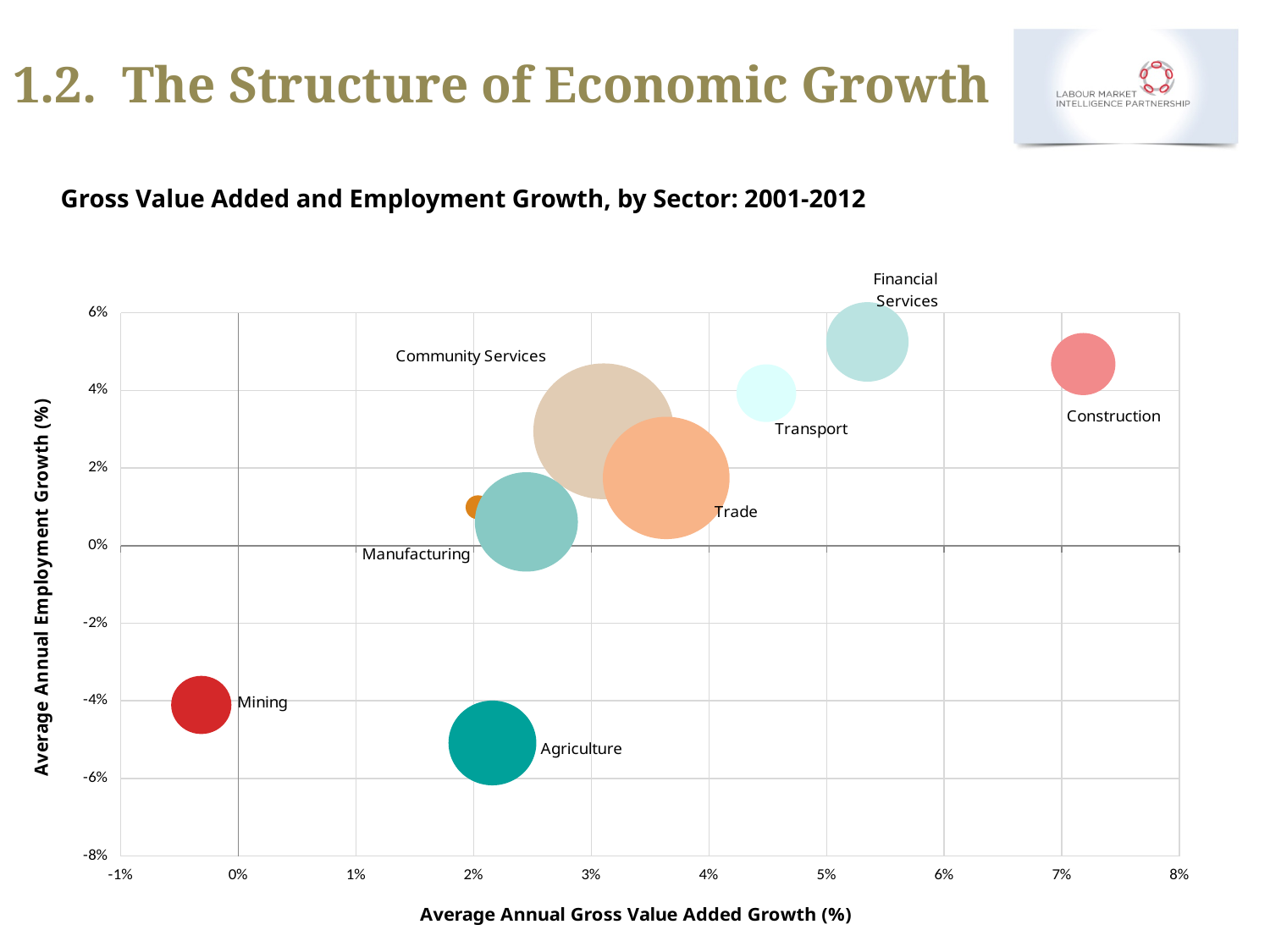
Is the average annual gross value added growth for Construction greater or less than 6%? greater What is the label of the horizontal axis? Average Annual Gross Value Added Growth (%) Which sector has the lowest average annual gross value added growth? Mining Which sector has the highest average annual gross value added growth? Construction Is the average annual gross value added growth for Mining greater or less than 0%? less Is the average annual employment growth for Mining greater or less than -2%? less Which sector has the highest average annual employment growth? Financial Services Which sector has the lowest average annual employment growth? Agriculture Which has the higher average annual employment growth, Transport or Trade? Transport What is the title of the chart? Gross Value Added and Employment Growth, by Sector: 2001-2012 What kind of chart is shown on the slide? Bubble chart